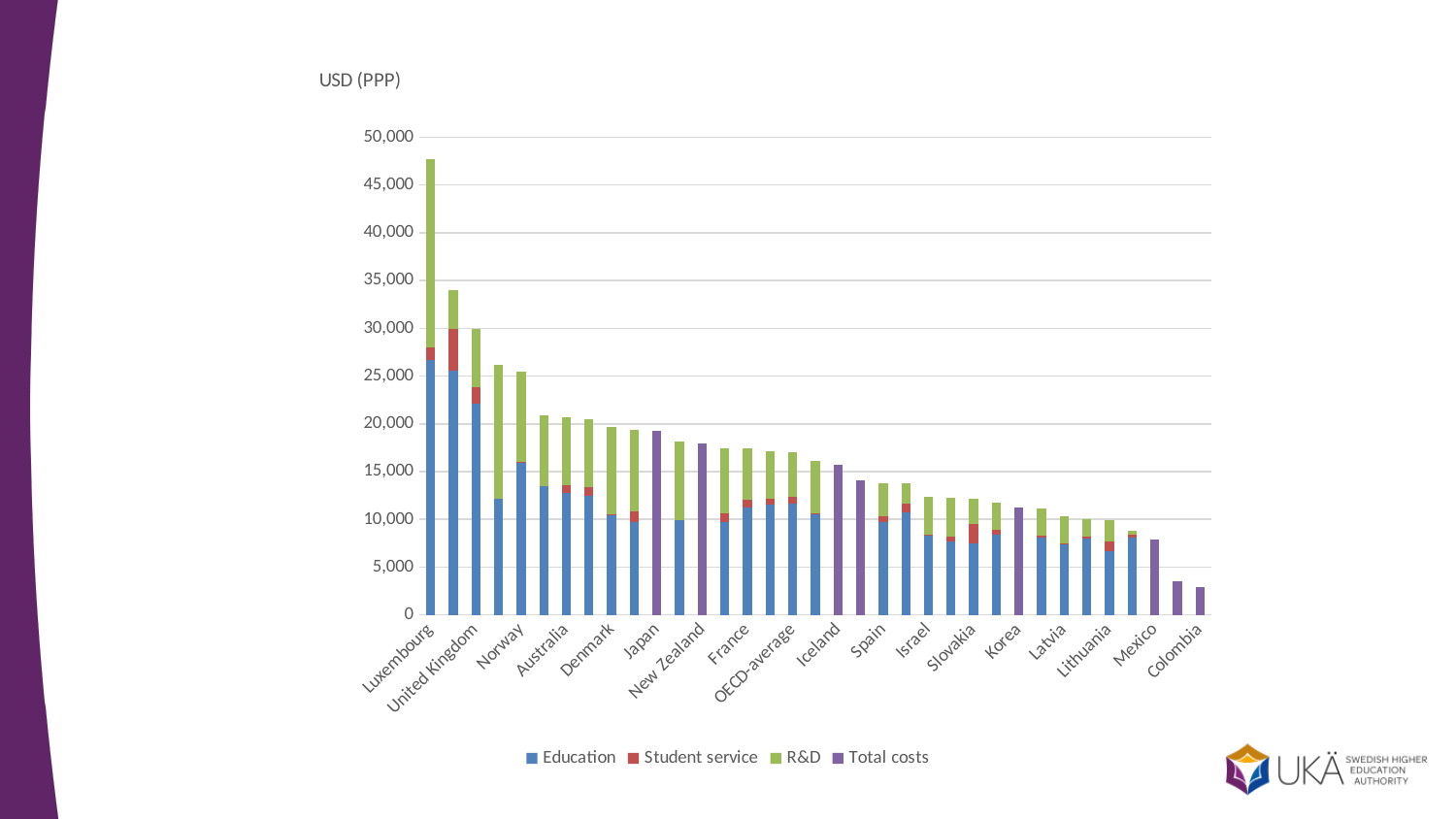
Which category has the highest total bar? Luxembourg Do the bar totals generally rise or fall from left to right along the x axis? fall What unit label is shown above the chart? USD (PPP) Is the value for Colombia greater or less than 5,000? less Which labelled category has the lowest bar? Colombia Is the total value for Luxembourg greater or less than 45,000? greater Which has a larger total bar, Luxembourg or United Kingdom? Luxembourg Is the value for Korea greater or less than 10,000? greater What kind of chart is shown on the slide? Stacked bar chart How many series does the legend list? 4